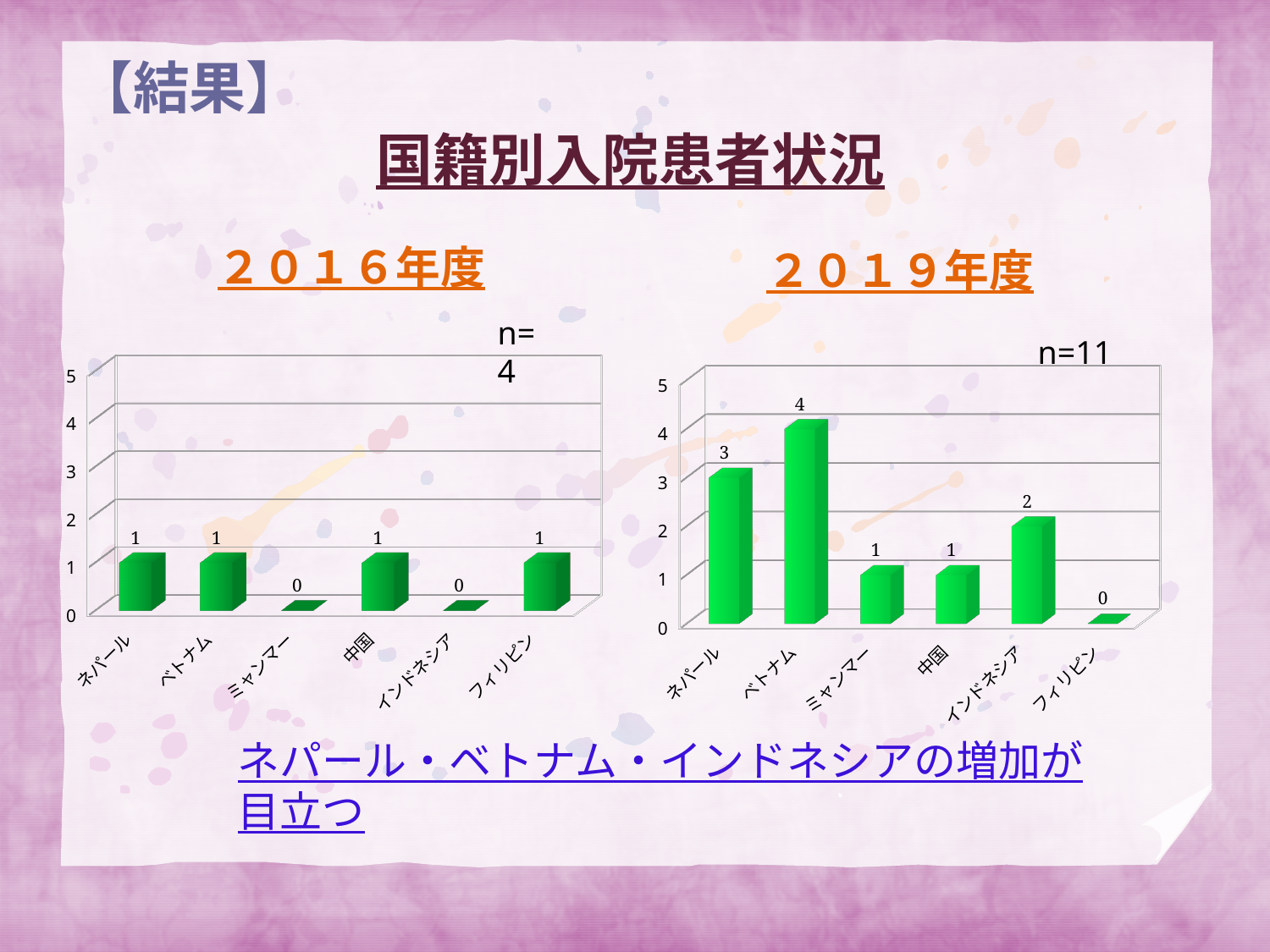
In the 2019年度 chart, what is the difference between the values for ネパール and ミャンマー? 2 In the 2019年度 chart, which is larger, the value for ネパール or the value for 中国? ネパール In the 2019年度 chart, which category has the highest value? ベトナム What is the n value shown above the 2019年度 chart? n=11 In the 2019年度 chart, what is the difference between the values for ベトナム and インドネシア? 2 In the 2019年度 chart, what is the value for ベトナム? 4 In the 2019年度 chart, which category has the lowest value? フィリピン In the 2016年度 chart, what is the value for ミャンマー? 0 In the 2019年度 chart, what is the value for ネパール? 3 In the 2016年度 chart, what is the value for インドネシア? 0 How many categories are shown on the x axis of the 2016年度 chart? 6 What kind of chart is the 2016年度 chart? bar chart